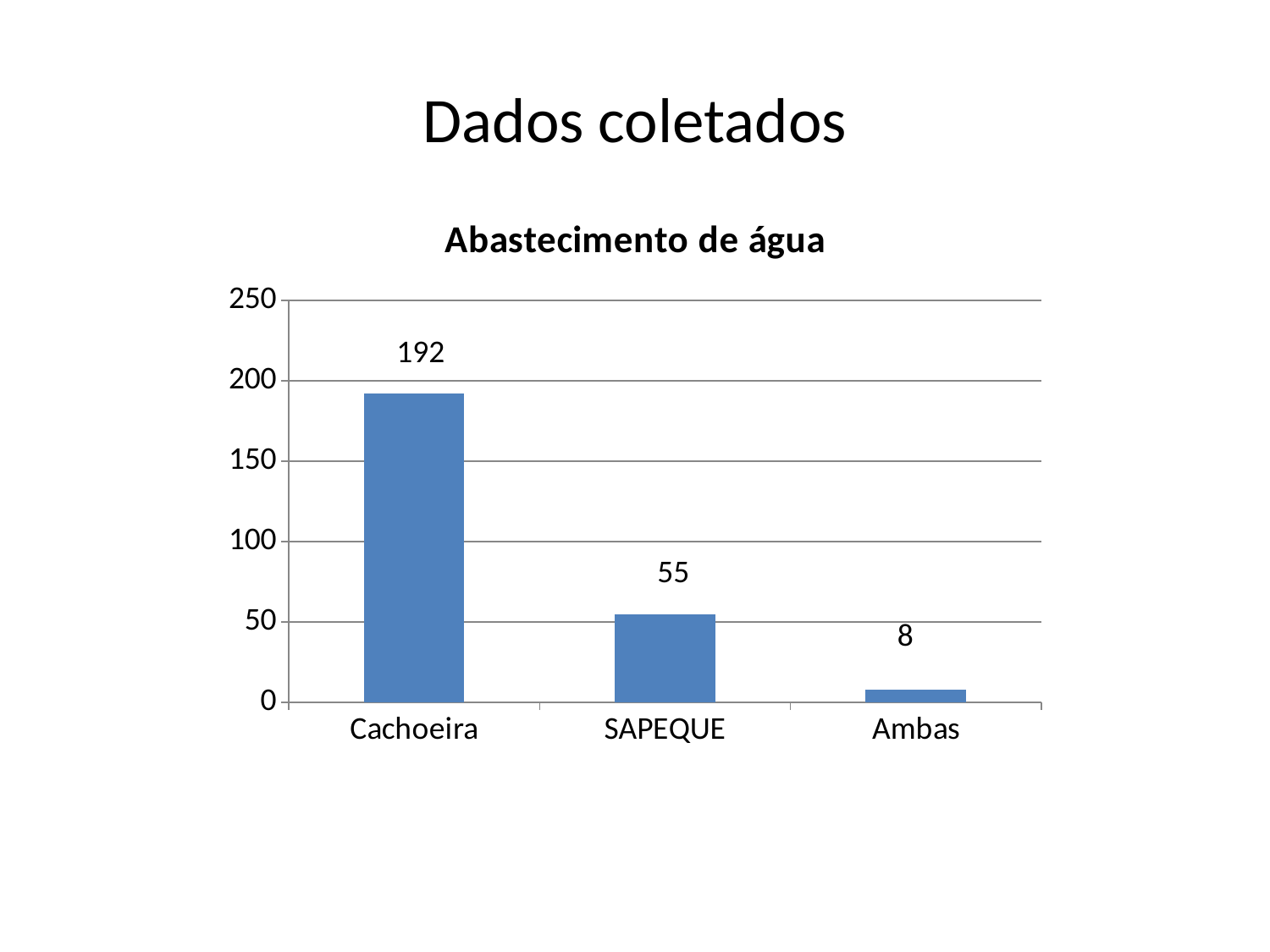
What is the value for Cachoeira? 192 How many categories are shown on the x axis? 3 Which category has the lowest value? Ambas Which is larger, the value for SAPEQUE or the value for Ambas? SAPEQUE What is the title of the chart? Abastecimento de água What is the difference between the values for SAPEQUE and Ambas? 47 What is the difference between the values for Cachoeira and SAPEQUE? 137 What is the value for Ambas? 8 Which category has the highest value? Cachoeira What is the value for SAPEQUE? 55 What kind of chart is shown on the slide? bar chart Is the value for Cachoeira greater or less than 150? greater